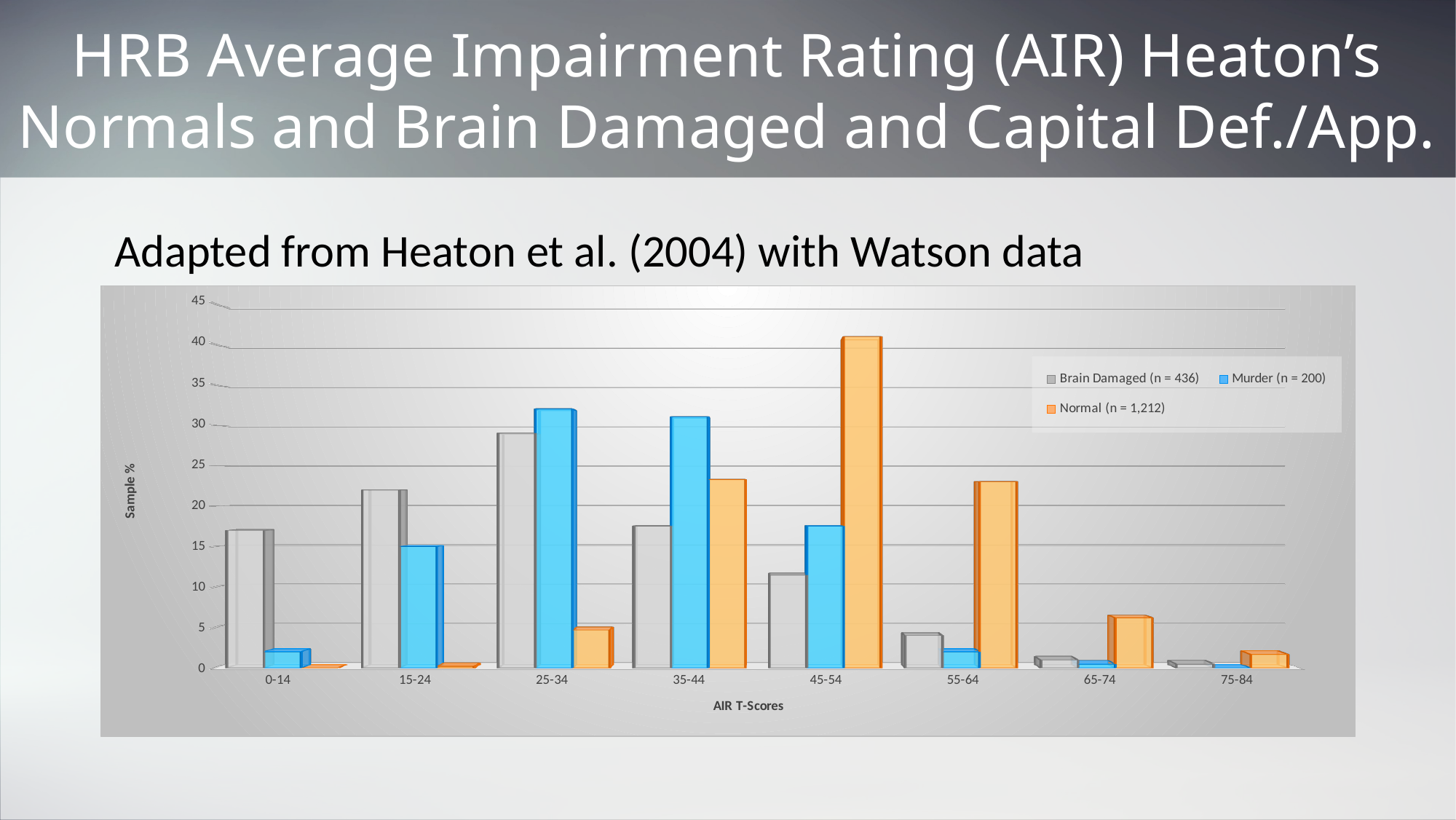
What is the title of the x axis of the chart? AIR T-Scores For the Brain Damaged (n = 436) series, which AIR T-Score category has the highest value? 25-34 For the Normal (n = 1,212) series, which AIR T-Score category has the highest value? 45-54 What kind of chart is shown on the slide? bar chart Do the values for the Normal (n = 1,212) series rise or fall from the 45-54 category to the 75-84 category? fall How many series does the legend list? 3 How many AIR T-Score categories are shown on the x axis? 8 Is the value for Brain Damaged (n = 436) in the 15-24 category greater or less than 20? greater In the 0-14 category, which is larger: Brain Damaged (n = 436) or Murder (n = 200)? Brain Damaged (n = 436) Is the value for Normal (n = 1,212) in the 45-54 category greater or less than 35? greater In the 35-44 category, which is larger: Murder (n = 200) or Normal (n = 1,212)? Murder (n = 200) Is the value for Murder (n = 200) in the 25-34 category greater or less than 30? greater